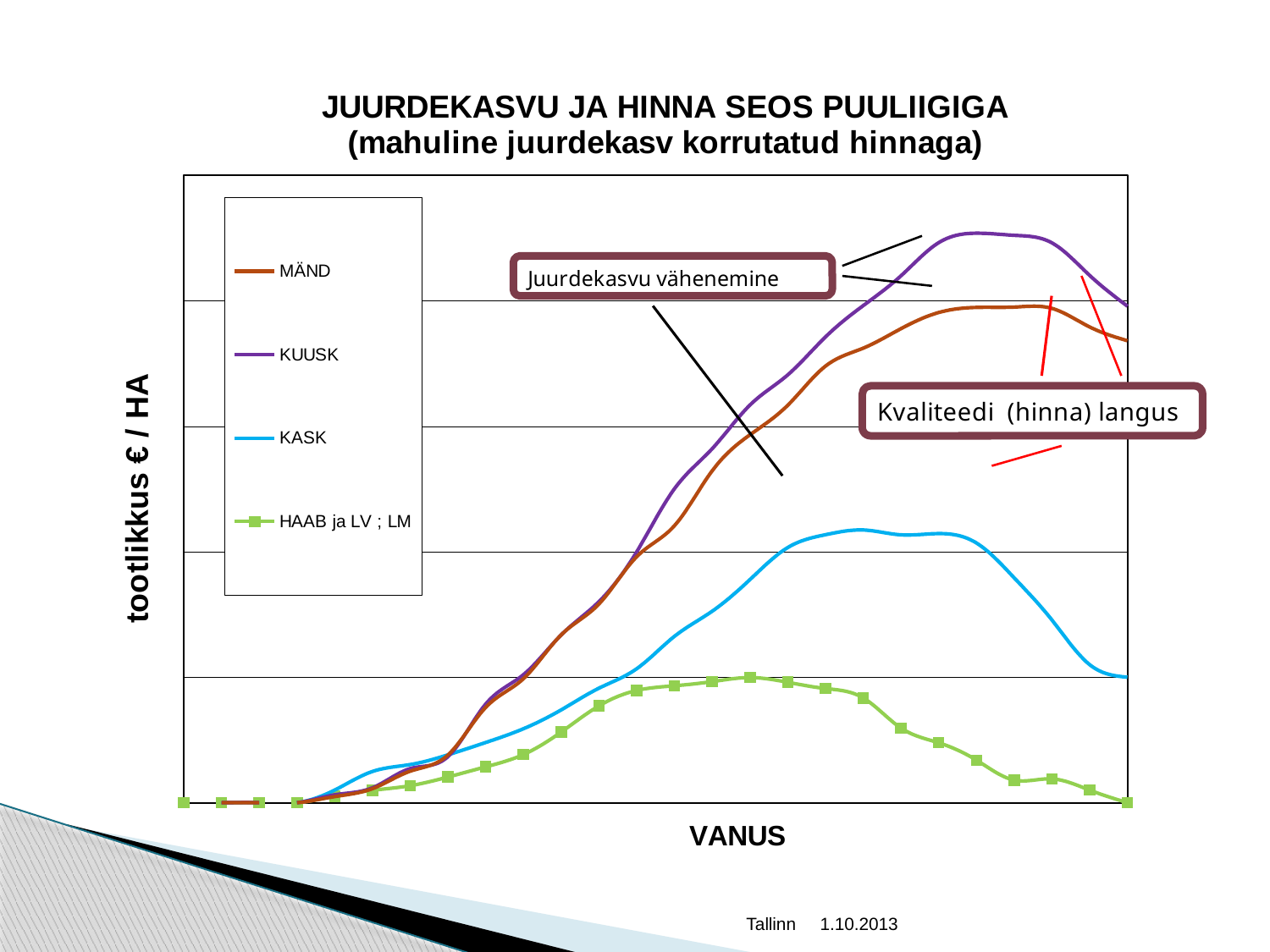
Does the KUUSK series rise or fall after reaching its peak toward the right end of the x axis? fall Does the MÄND series rise or fall over the left half of the x axis? rise Which series peaks higher, KASK or MÄND? MÄND Which series is drawn with square markers? HAAB ja LV ; LM What kind of chart is shown on the slide? line chart How many series does the chart's legend list? 4 Which series peaks higher, KASK or HAAB ja LV ; LM? KASK Which series reaches the highest peak on the chart? KUUSK Which series stays lowest across the chart? HAAB ja LV ; LM What is the title of the x axis? VANUS What is the title of the y axis? tootlikkus € / HA